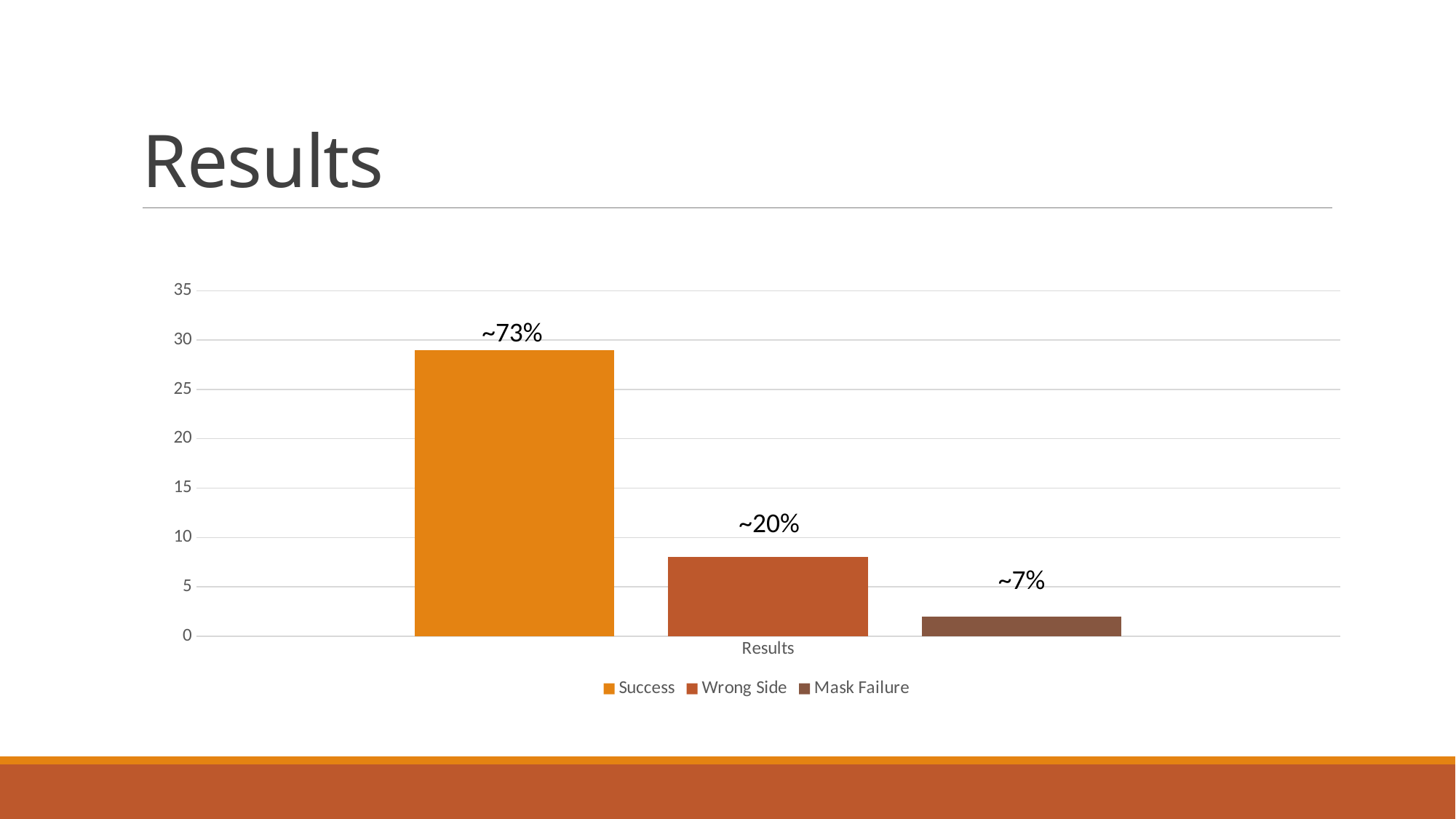
How many bars are plotted in the chart? 3 Which is larger, the Success bar or the Wrong Side bar? Success What is the category label shown on the x axis of the chart? Results Which series has the tallest bar? Success Which is larger, the Wrong Side bar or the Mask Failure bar? Wrong Side How many series does the legend list? 3 What kind of chart is shown on the slide? bar chart Is the value for Mask Failure greater or less than 5? less Is the value for Wrong Side greater or less than 10? less Which series has the shortest bar? Mask Failure Is the value for Success greater or less than 25? greater